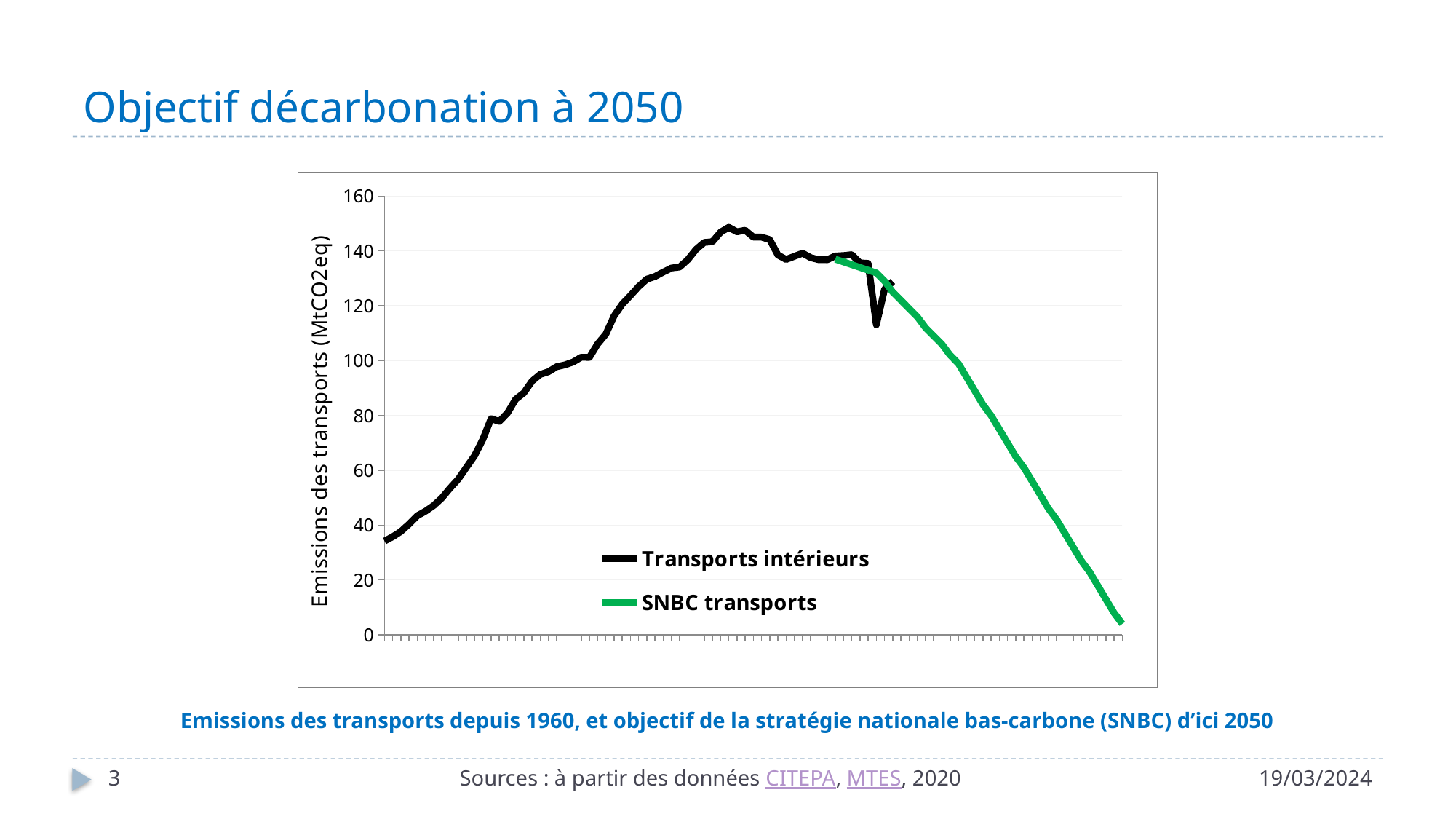
Does the SNBC transports line rise or fall along the x axis? falls What is the title of the vertical axis? Emissions des transports (MtCO2eq) Is the lowest point of the sharp dip near the end of the Transports intérieurs line greater or less than 120? less Is the peak value of the Transports intérieurs line greater or less than 140? greater Which series reaches the higher maximum value, Transports intérieurs or SNBC transports? Transports intérieurs Does the Transports intérieurs line rise or fall over the first half of the chart? rises How many series does the legend list? 2 What are the two series named in the legend? Transports intérieurs and SNBC transports What kind of chart is shown on the slide? line chart Is the highest value on the vertical axis greater or less than 150? greater